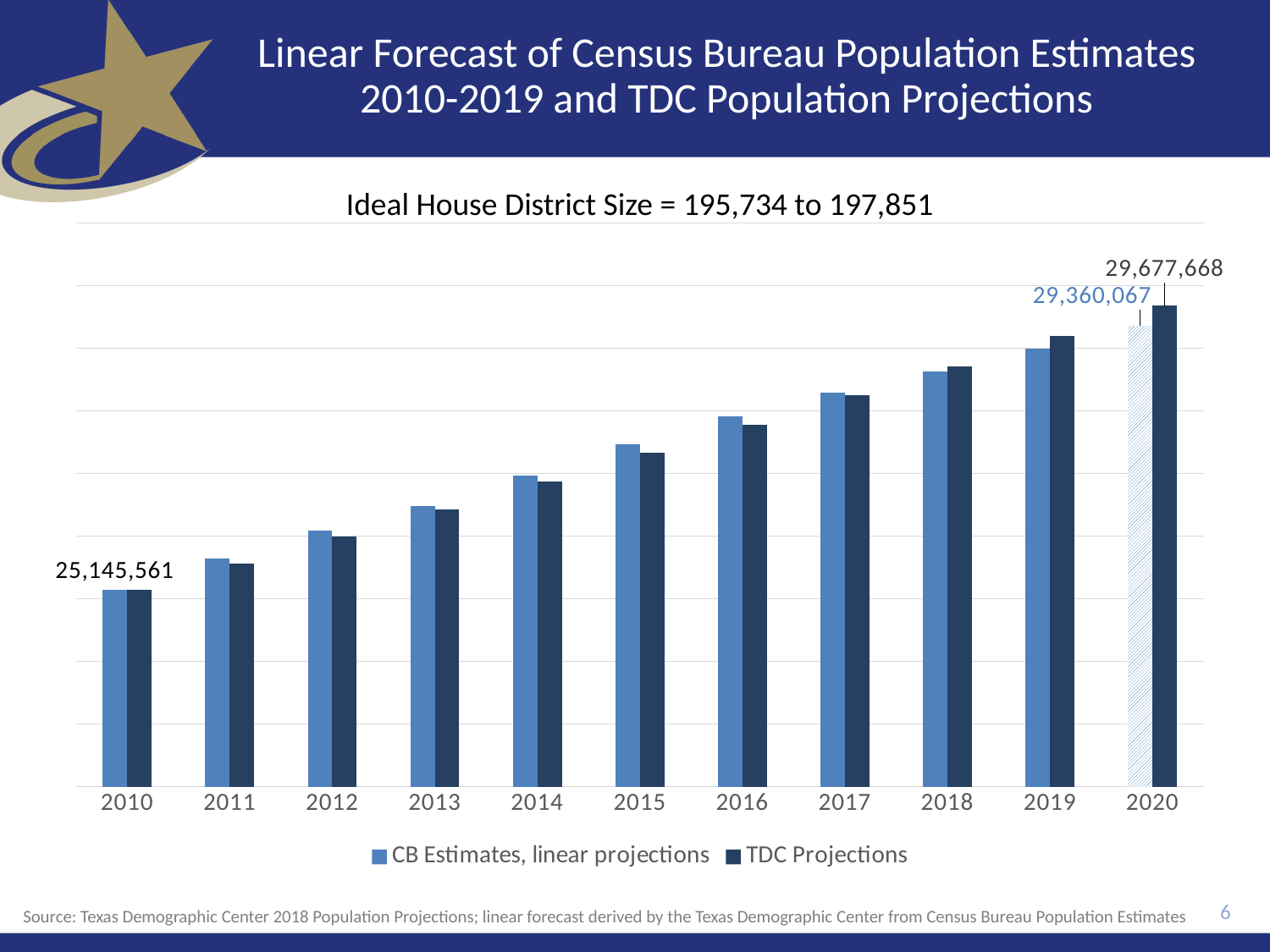
Which year has the lowest values in the chart? 2010 What is the CB Estimates, linear projections value for 2020? 29,360,067 What is the TDC Projections value for 2020? 29,677,668 How many series does the chart legend list? 2 For 2016, which is larger: the CB Estimates, linear projections value or the TDC Projections value? CB Estimates, linear projections For 2020, which is larger: the TDC Projections value or the CB Estimates, linear projections value? TDC Projections What type of chart is shown on the slide? bar chart How many years are shown on the x axis of the chart? 11 What are the two series named in the chart legend? CB Estimates, linear projections; TDC Projections Do the values rise or fall from 2010 to 2020? rise What value is labeled on the chart for 2010? 25,145,561 What is the difference between the TDC Projections value and the CB Estimates, linear projections value for 2020? 317,601